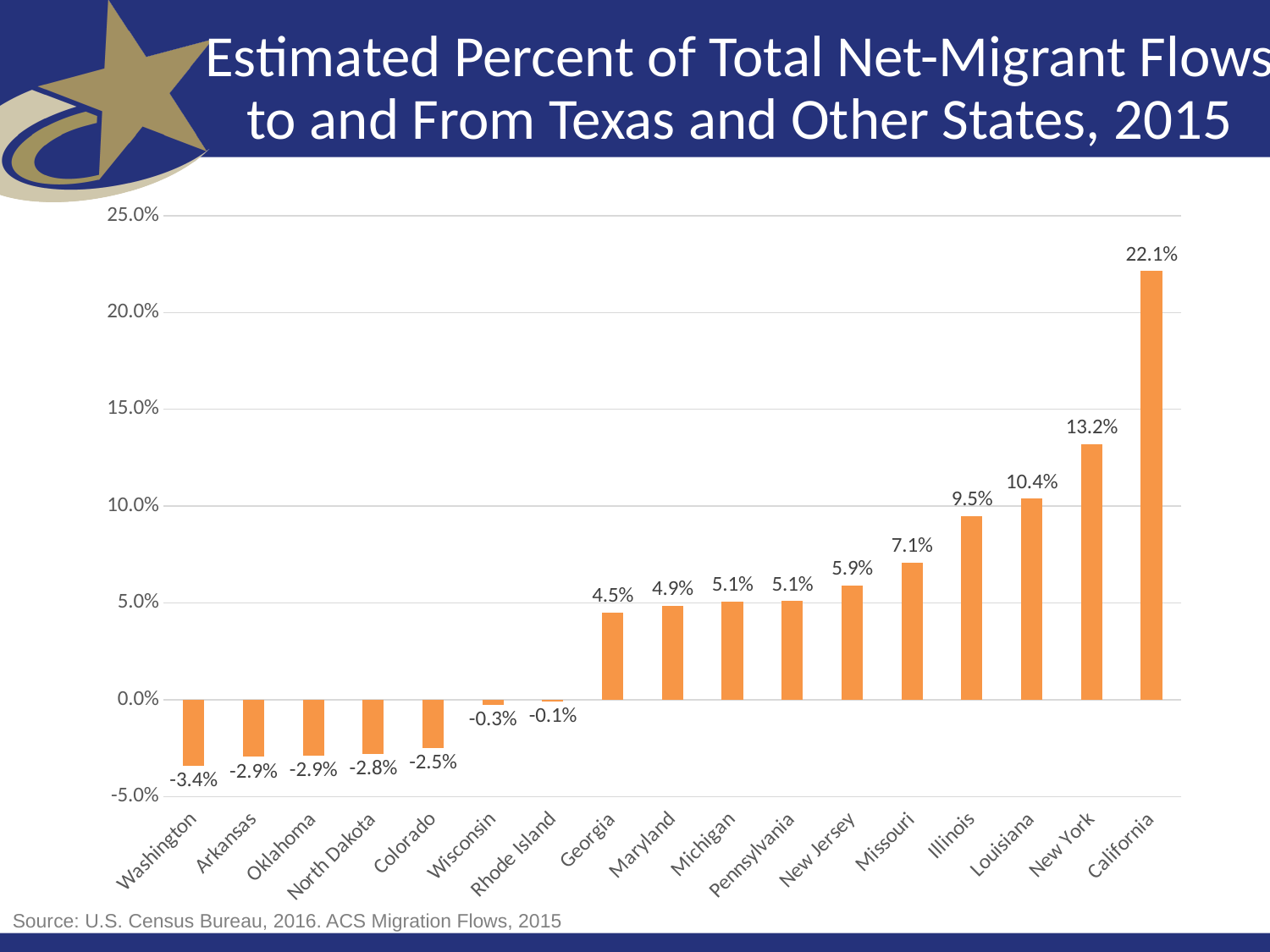
How many states are shown on the x axis? 17 Which is larger, the value for New Jersey or the value for Georgia? New Jersey What is the difference between the values for California and New York? 8.9% What is the value for Washington? -3.4% What is the difference between the values for Louisiana and Illinois? 0.9% Which state has the highest value? California Which state has the lowest value? Washington Do the values rise or fall moving from left to right along the x axis? rise What is the value for California? 22.1% What is the value for Missouri? 7.1% What kind of chart is shown on the slide? bar chart Is the value for New York greater or less than 10.0%? greater